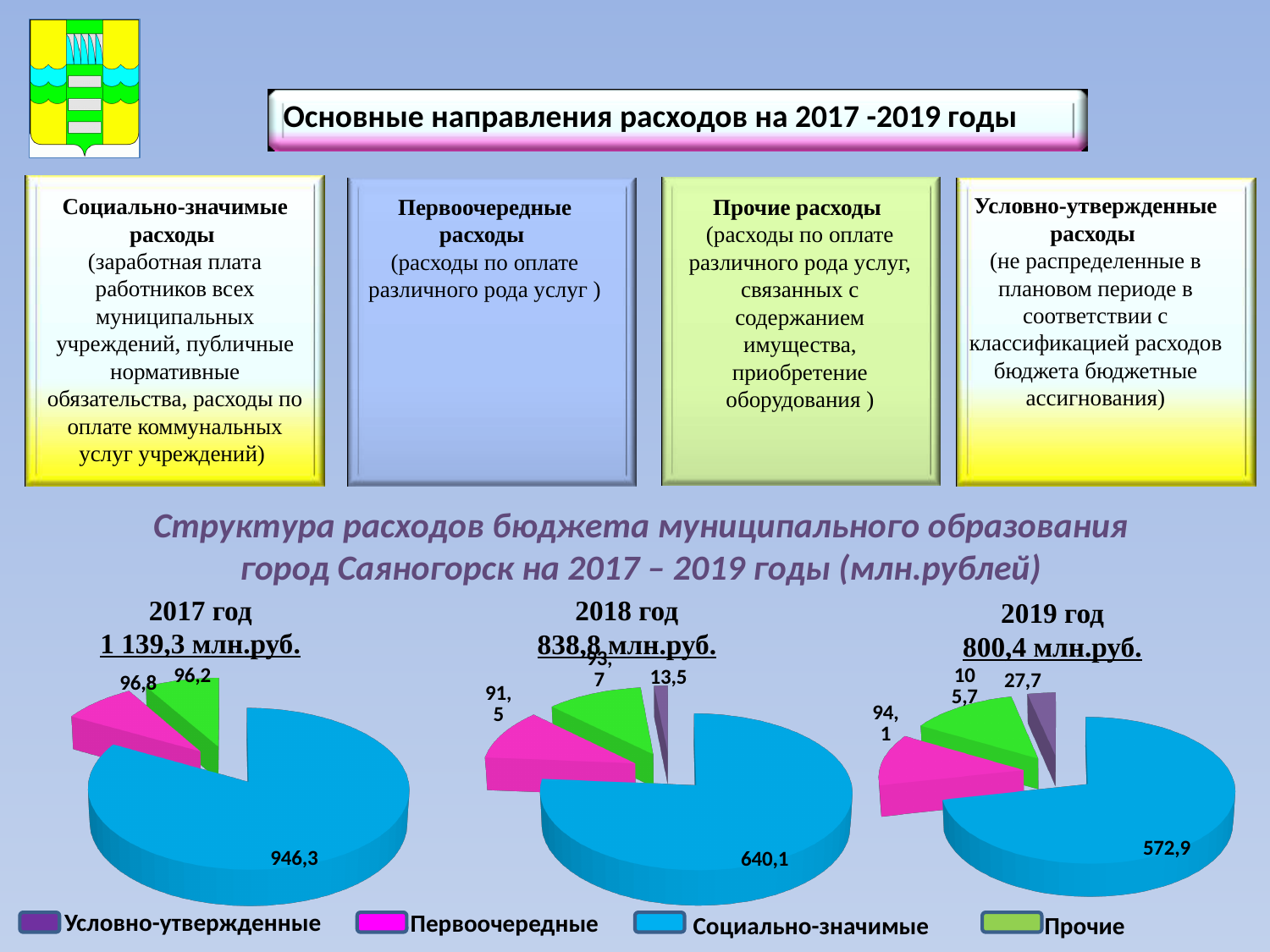
In the 2019 год chart, what is the value of the Социально-значимые slice? 572,9 In the 2018 год chart, which category has the smallest slice? Условно-утвержденные In the 2017 год chart, what is the difference between the Социально-значимые slice and the Первоочередные slice? 849,5 In the 2018 год chart, which category has the largest slice? Социально-значимые How many categories does the legend list? 4 In the 2019 год chart, what is the value of the Условно-утвержденные slice? 27,7 What kind of chart is used for the 2017 год chart? pie chart In the 2018 год chart, what is the value of the Условно-утвержденные slice? 13,5 In the 2017 год chart, what is the value of the Социально-значимые slice? 946,3 In the 2019 год chart, which is larger: the Первоочередные slice or the Условно-утвержденные slice? Первоочередные Across the 2017, 2018 and 2019 charts, does the value of the Социально-значимые slice rise or fall? fall How many slices does the 2017 год chart have? 3